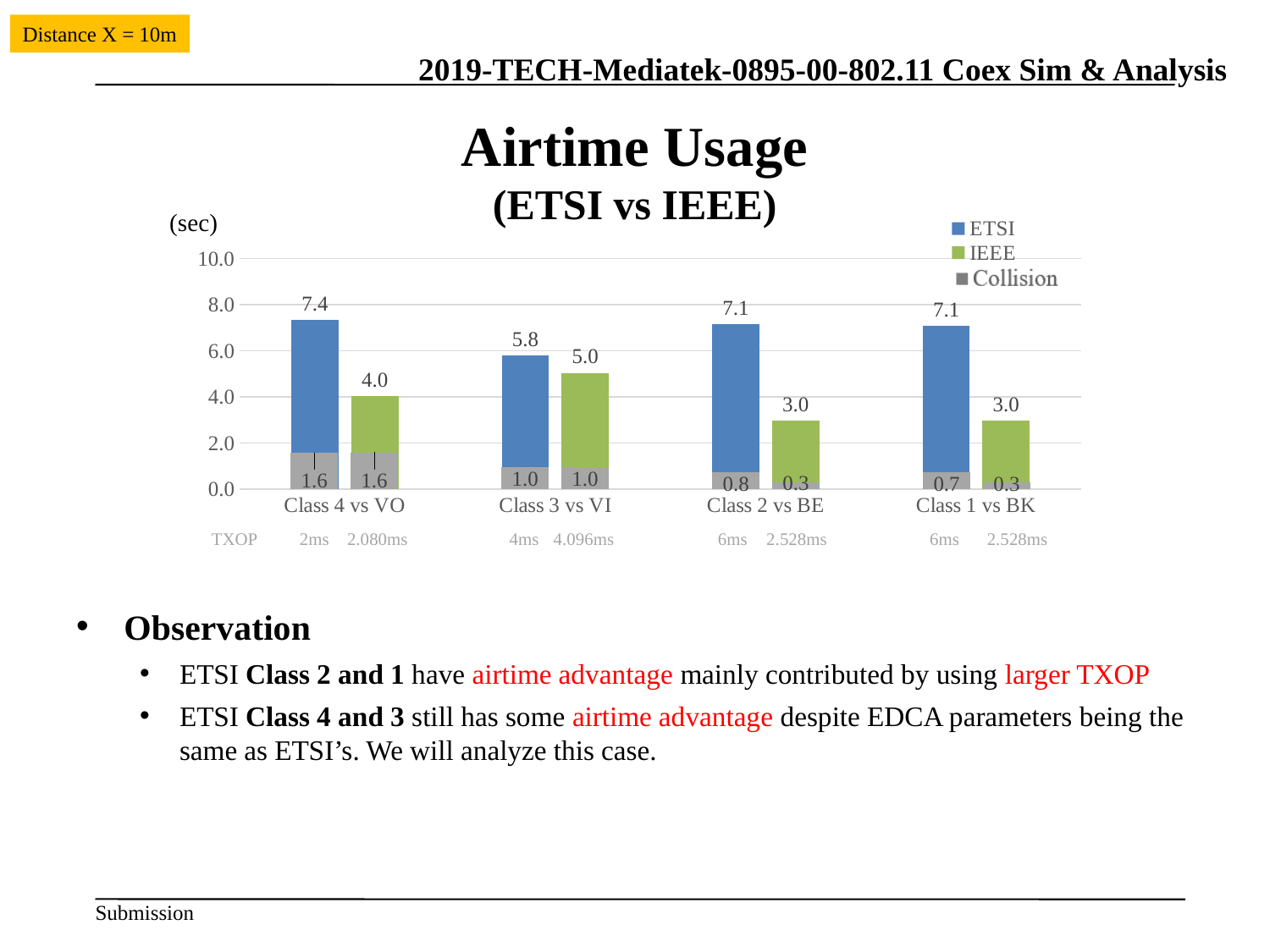
Which category has the lowest ETSI airtime usage? Class 3 vs VI What is the difference between the ETSI and IEEE airtime usage for Class 2 vs BE? 4.1 What is the ETSI airtime usage for Class 1 vs BK? 7.1 What is the ETSI airtime usage for Class 4 vs VO? 7.4 How many categories are shown on the x axis? 4 What is the IEEE airtime usage for Class 3 vs VI? 5.0 Which category has the highest ETSI airtime usage? Class 4 vs VO What unit is shown on the y axis of the chart? sec How many series does the legend list? 3 What is the IEEE airtime usage for Class 2 vs BE? 3.0 What kind of chart is shown on the slide? Bar chart Which is larger for Class 3 vs VI, the ETSI value or the IEEE value? ETSI